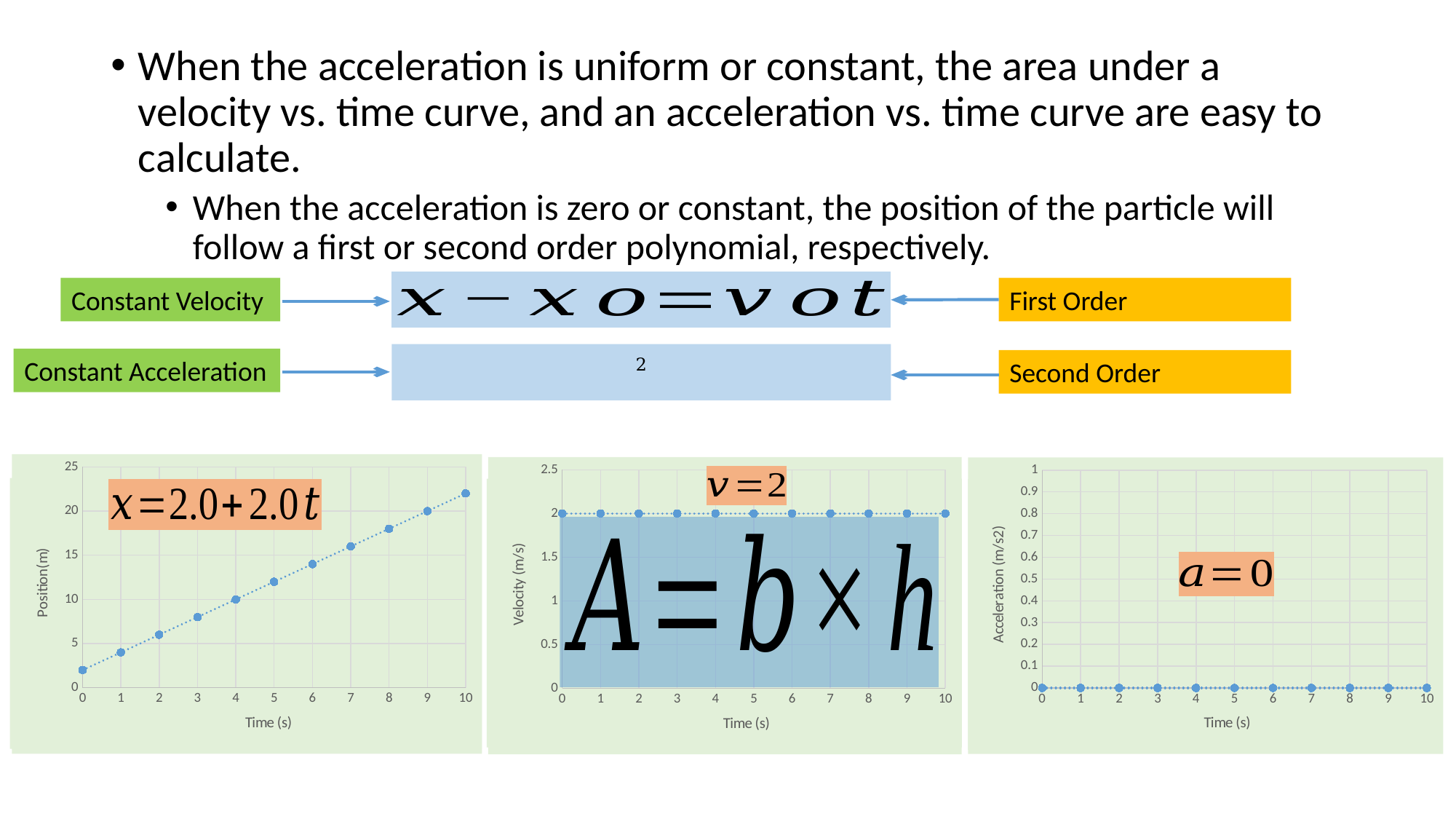
In the left chart (Position vs Time), at which time is the position highest? 10 In the left chart (Position vs Time), do the values rise or fall as time increases? rise What is the x-axis label of the left chart? Time (s) In the left chart (Position vs Time), what is the position at time 9 s? 20 In the left chart (Position vs Time), what is the position at time 4 s? 10 In the right chart (Acceleration vs Time), what is the acceleration at time 3 s? 0 In the left chart (Position vs Time), is the position at time 2 s greater or less than 10? less In the left chart (Position vs Time), is the position at time 7 s greater or less than 15? greater In the left chart (Position vs Time), how many data points are plotted? 11 What is the y-axis label of the right chart? Acceleration (m/s2) In the middle chart (Velocity vs Time), do the values rise, fall, or stay constant as time increases? stay constant In the middle chart (Velocity vs Time), what is the velocity at time 5 s? 2